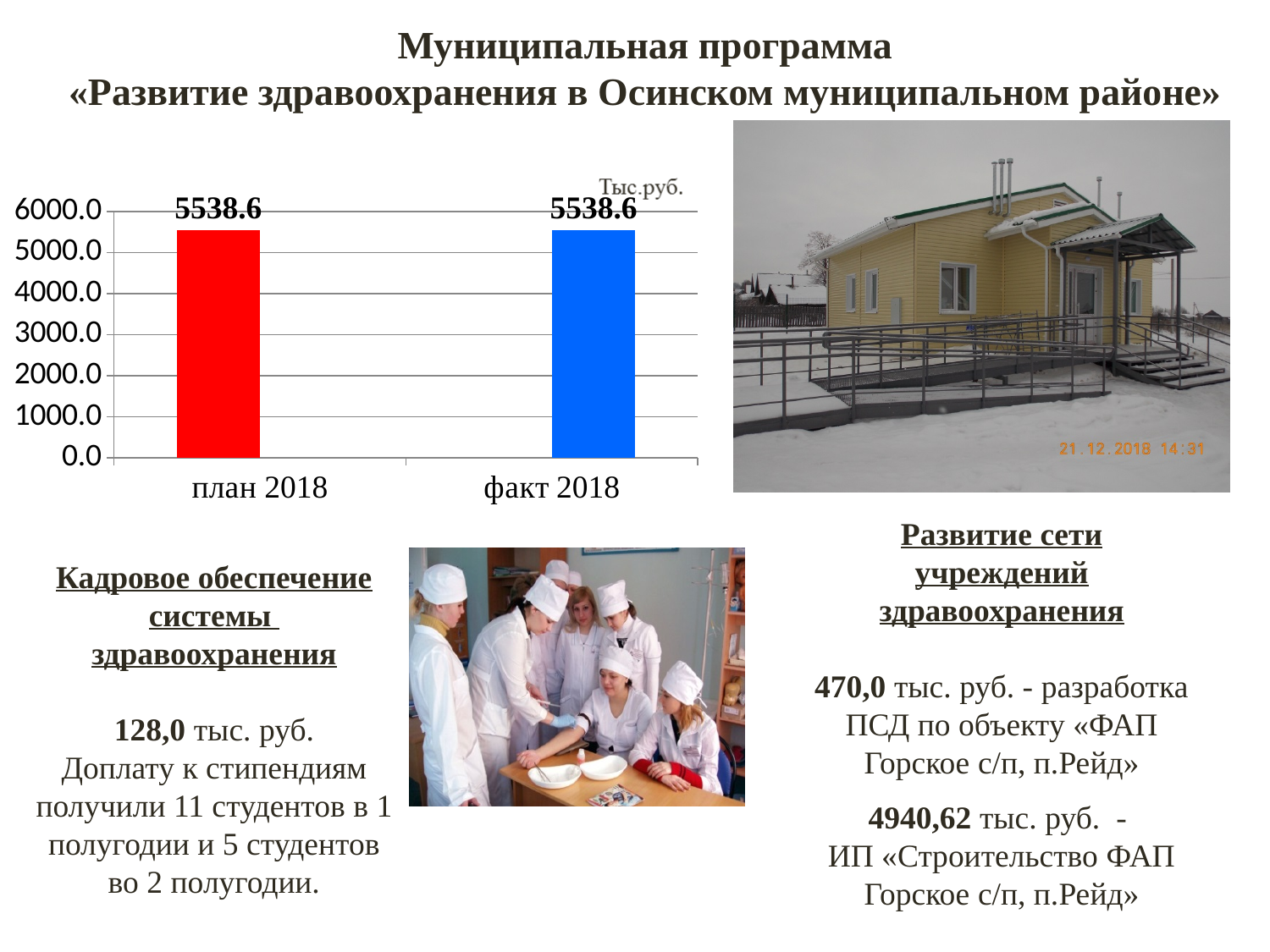
What unit label is shown above the bar chart? Тыс.руб. What colour is the bar for план 2018 on the bar chart? Red What is the difference between the values for план 2018 and факт 2018 on the bar chart? 0.0 How many categories are shown on the bar chart? 2 Is the value for факт 2018 on the bar chart greater or less than 6000.0? less Is the value for план 2018 on the bar chart greater or less than 5000.0? greater What is the value for факт 2018 on the bar chart? 5538.6 What is the value for план 2018 on the bar chart? 5538.6 Which is larger on the bar chart, the value for план 2018 or the value for факт 2018? They are equal What kind of chart is shown on the slide? Bar chart